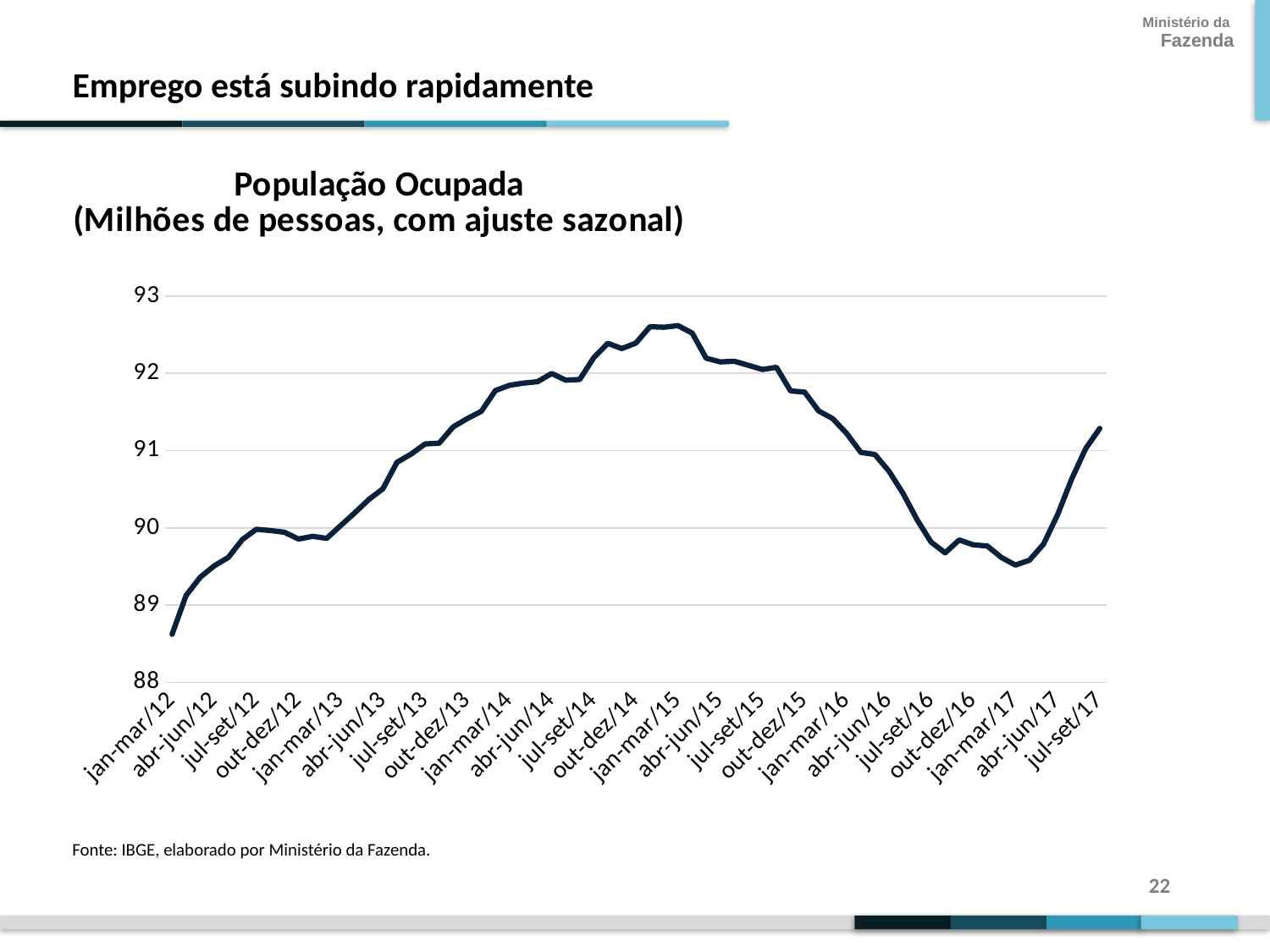
In what unit is the chart's data expressed, according to the subtitle? Milhões de pessoas Is the value for jul-set/17 greater or less than 91? greater Which is larger, the value for jan-mar/15 or the value for jan-mar/17? jan-mar/15 Is the value for jan-mar/17 greater or less than 90? less Does the line rise or fall between jan-mar/15 and jan-mar/17? fall What kind of chart is shown on the slide? line chart At which period is the line at its lowest value? jan-mar/12 Is the value for jan-mar/12 greater or less than 89? less What is the title of the chart? População Ocupada Around which period does the line reach its highest value? jan-mar/15